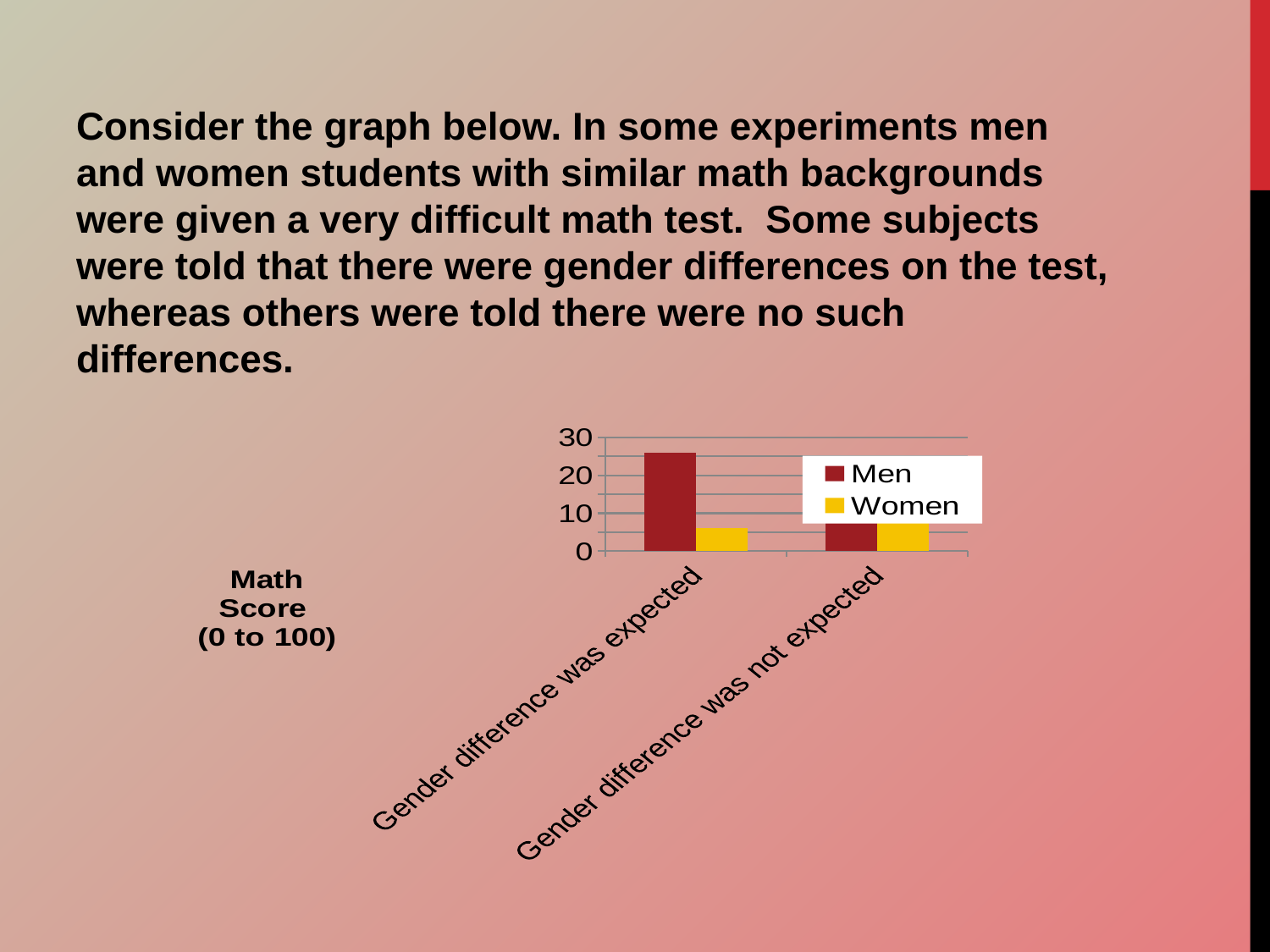
Is the value for Men in the 'Gender difference was expected' condition greater or less than 20? greater What colour are the bars for the Women series? yellow What kind of chart is shown on the slide? bar chart Is the value for Women in the 'Gender difference was expected' condition greater or less than 10? less Which series does the legend list first? Men How many categories are shown on the x axis? 2 In the 'Gender difference was expected' condition, which series has the larger value, Men or Women? Men What is the highest tick value shown on the vertical axis? 30 Is the value for Men in the 'Gender difference was expected' condition greater or less than 30? less How many series does the legend list? 2 Which series and category combination has the highest bar in the chart? Men, Gender difference was expected